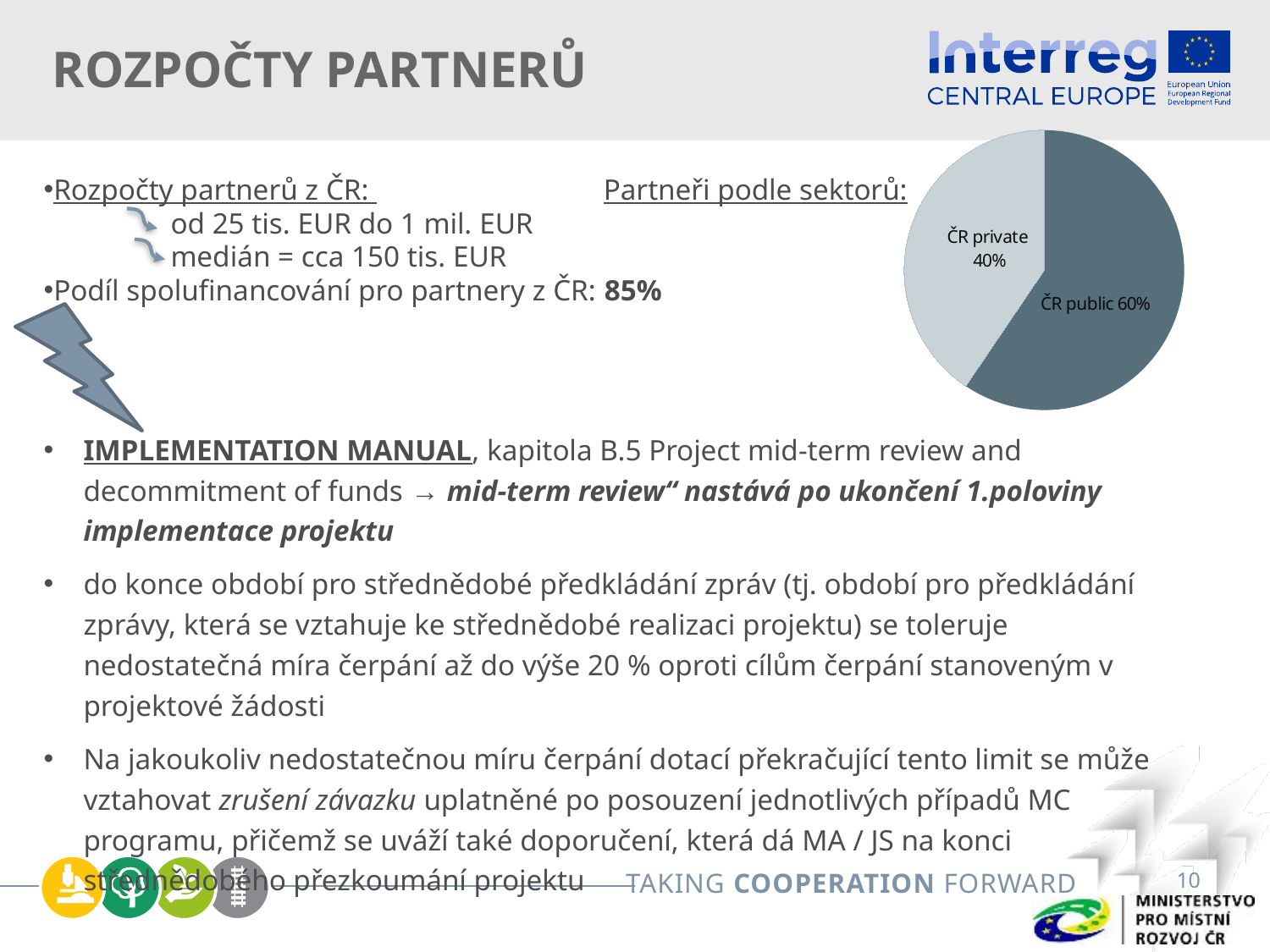
Which slice of the pie is drawn in the darker colour? ČR public What share of the pie does ČR public have? 60% What kind of chart is shown on the slide? pie chart How many slices does the pie chart have? 2 Which is larger, the ČR private slice or the ČR public slice? ČR public Which slice of the pie is the smallest? ČR private What is the difference in percentage points between the ČR public and ČR private slices? 20 What share of the pie does ČR private have? 40% Which slice of the pie is the largest? ČR public Is the share for ČR private greater or less than 50%? less What is the heading above the pie chart? Partneři podle sektorů: